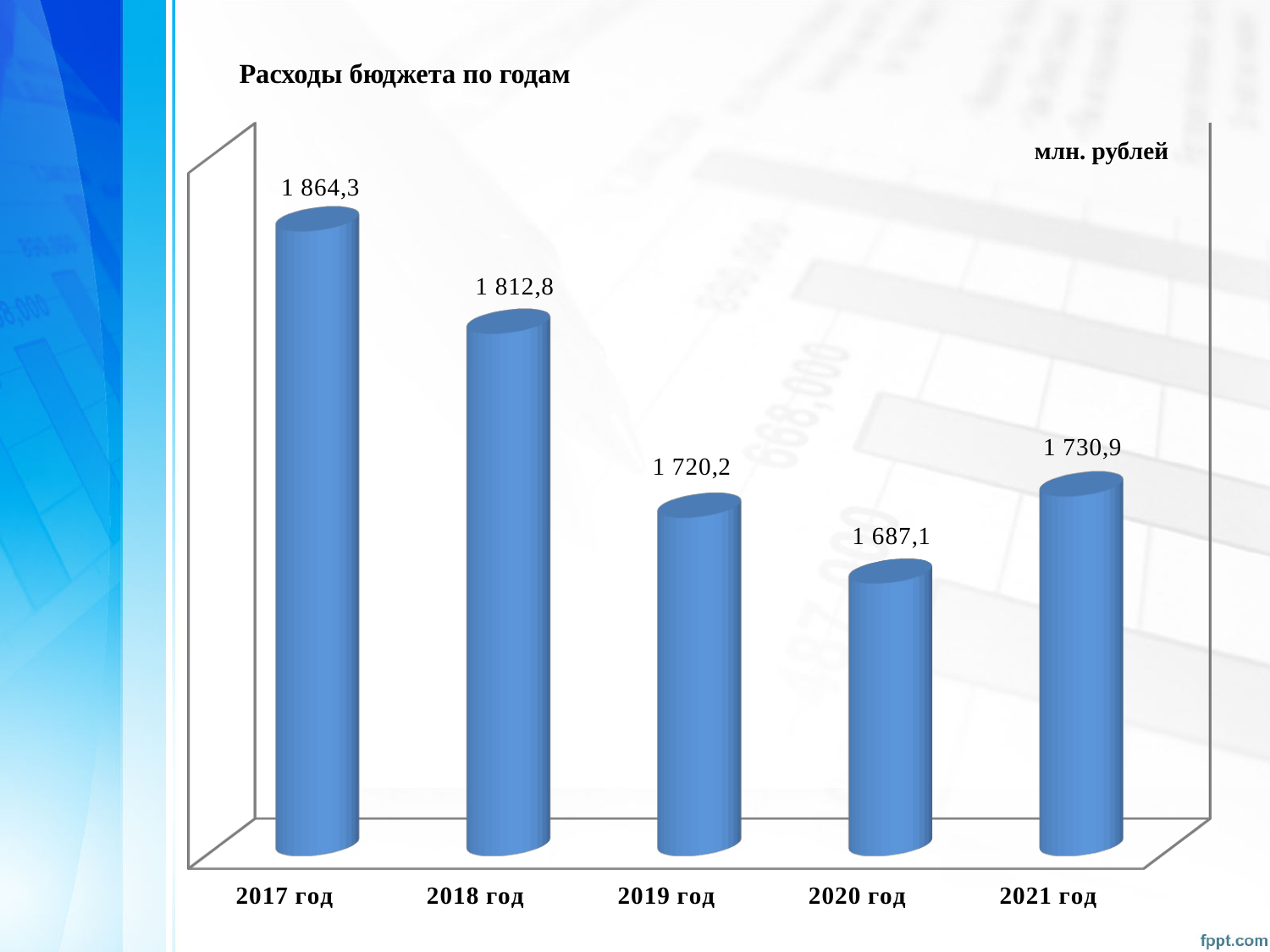
Which year has the highest budget expenditure? 2017 год What kind of chart is shown on the slide? Bar chart What unit of measurement is indicated on the chart? млн. рублей Which is larger, the value for 2019 год or the value for 2021 год? 2021 год Which year has the lowest budget expenditure? 2020 год What is the value shown for 2019 год? 1 720,2 What is the budget expenditure value for 2017 год? 1 864,3 What is the difference between the values for 2017 год and 2018 год? 51,5 What is the difference between the values for 2021 год and 2020 год? 43,8 Do the values rise or fall from 2017 год to 2020 год? Fall How many years are shown on the chart? 5 What is the value shown for 2021 год? 1 730,9